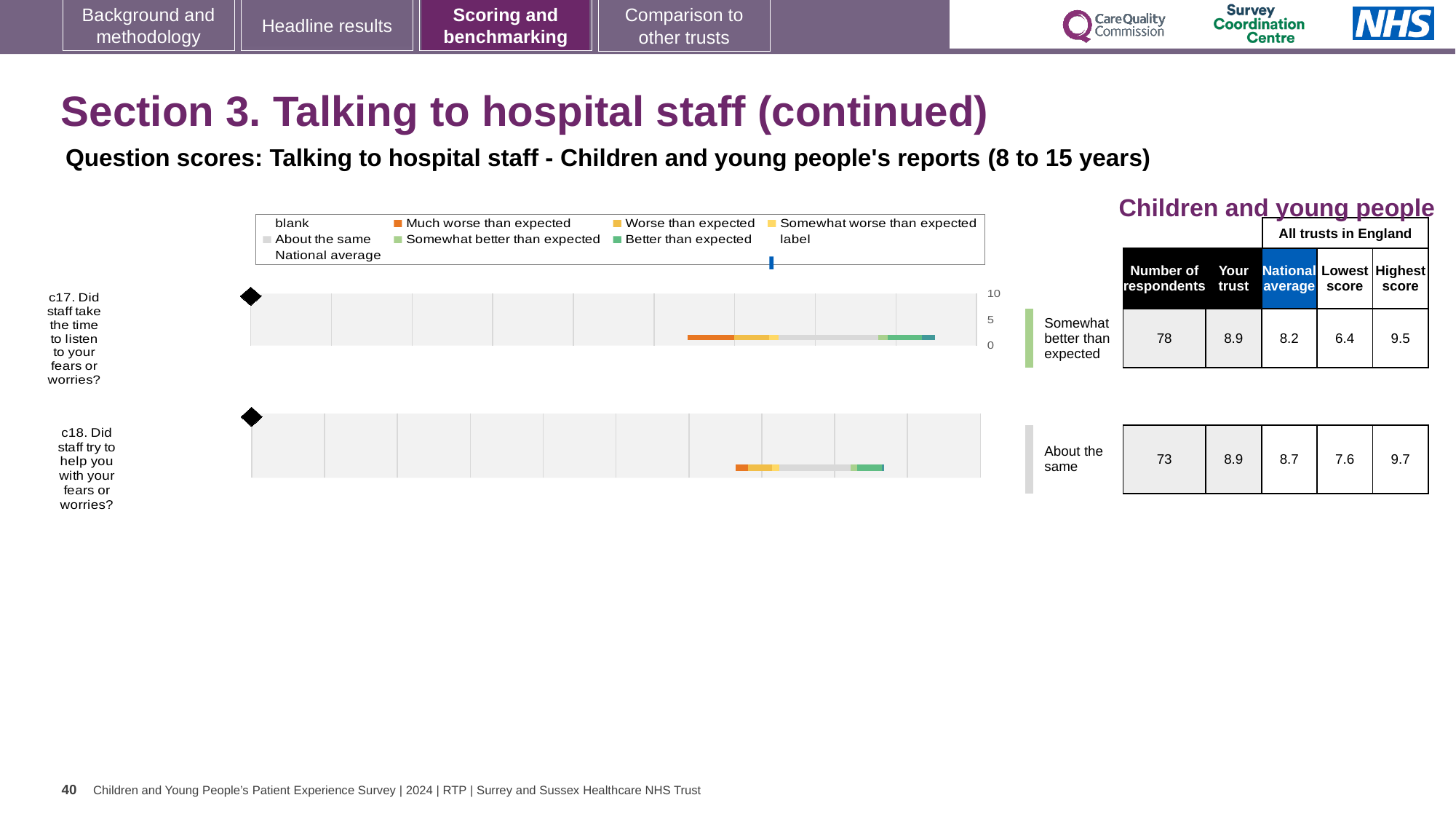
What is the highest value shown on the score axis of the c17 chart? 10 What is the difference between the highest score and the lowest score for c17? 3.1 What is the difference between the trust score and the national average for c17? 0.7 How many respondents answered c17? 78 What is the 'Your trust' score for c17? 8.9 Which benchmark category is shown for c18 'Did staff try to help you with your fears or worries?' About the same How many questions (rows) are plotted in the chart area? 2 Which question has the higher national average, c17 or c18? c18 What kind of chart is used to show the question scores for c17 and c18? bar chart Which benchmark category is shown for c17 'Did staff take the time to listen to your fears or worries?' Somewhat better than expected What is the national average score for c18? 8.7 What is the highest score among all trusts in England for c18? 9.7